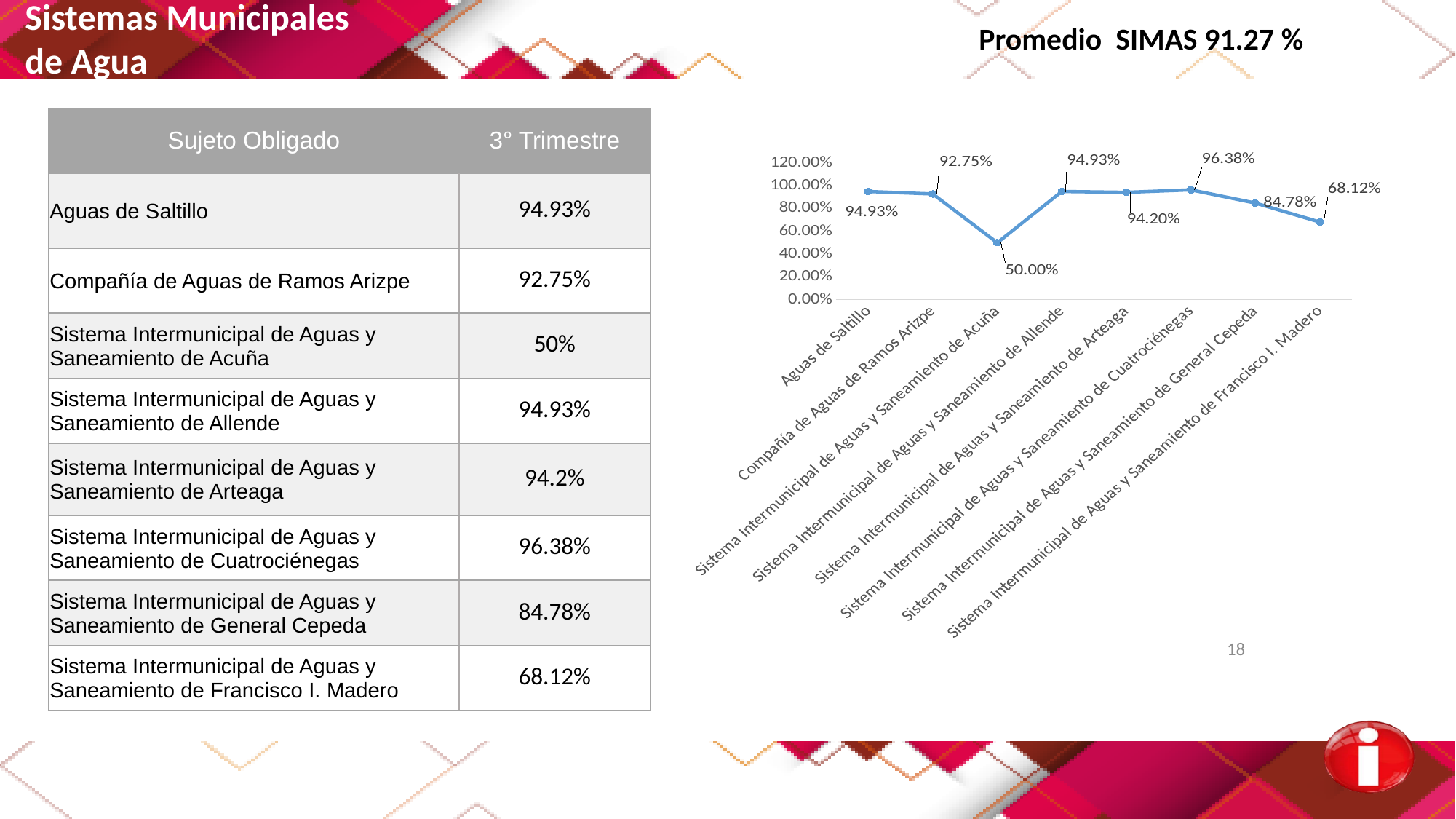
Which category has the highest value in the chart? Sistema Intermunicipal de Aguas y Saneamiento de Cuatrociénegas What value does the chart show for Aguas de Saltillo? 94.93% What is the difference between the values for Sistema Intermunicipal de Aguas y Saneamiento de Cuatrociénegas and Sistema Intermunicipal de Aguas y Saneamiento de General Cepeda? 11.60% What value does the chart show for Sistema Intermunicipal de Aguas y Saneamiento de Acuña? 50.00% What type of chart is shown on the slide? line chart What is the highest tick value shown on the chart's y axis? 120.00% Is the value for Sistema Intermunicipal de Aguas y Saneamiento de Francisco I. Madero greater or less than 80.00%? less Which category has the lowest value in the chart? Sistema Intermunicipal de Aguas y Saneamiento de Acuña How many categories are plotted along the x axis of the chart? 8 Does the line rise or fall from Sistema Intermunicipal de Aguas y Saneamiento de General Cepeda to Sistema Intermunicipal de Aguas y Saneamiento de Francisco I. Madero? fall Which has the larger value, Compañía de Aguas de Ramos Arizpe or Sistema Intermunicipal de Aguas y Saneamiento de Arteaga? Sistema Intermunicipal de Aguas y Saneamiento de Arteaga What value does the chart show for Sistema Intermunicipal de Aguas y Saneamiento de General Cepeda? 84.78%